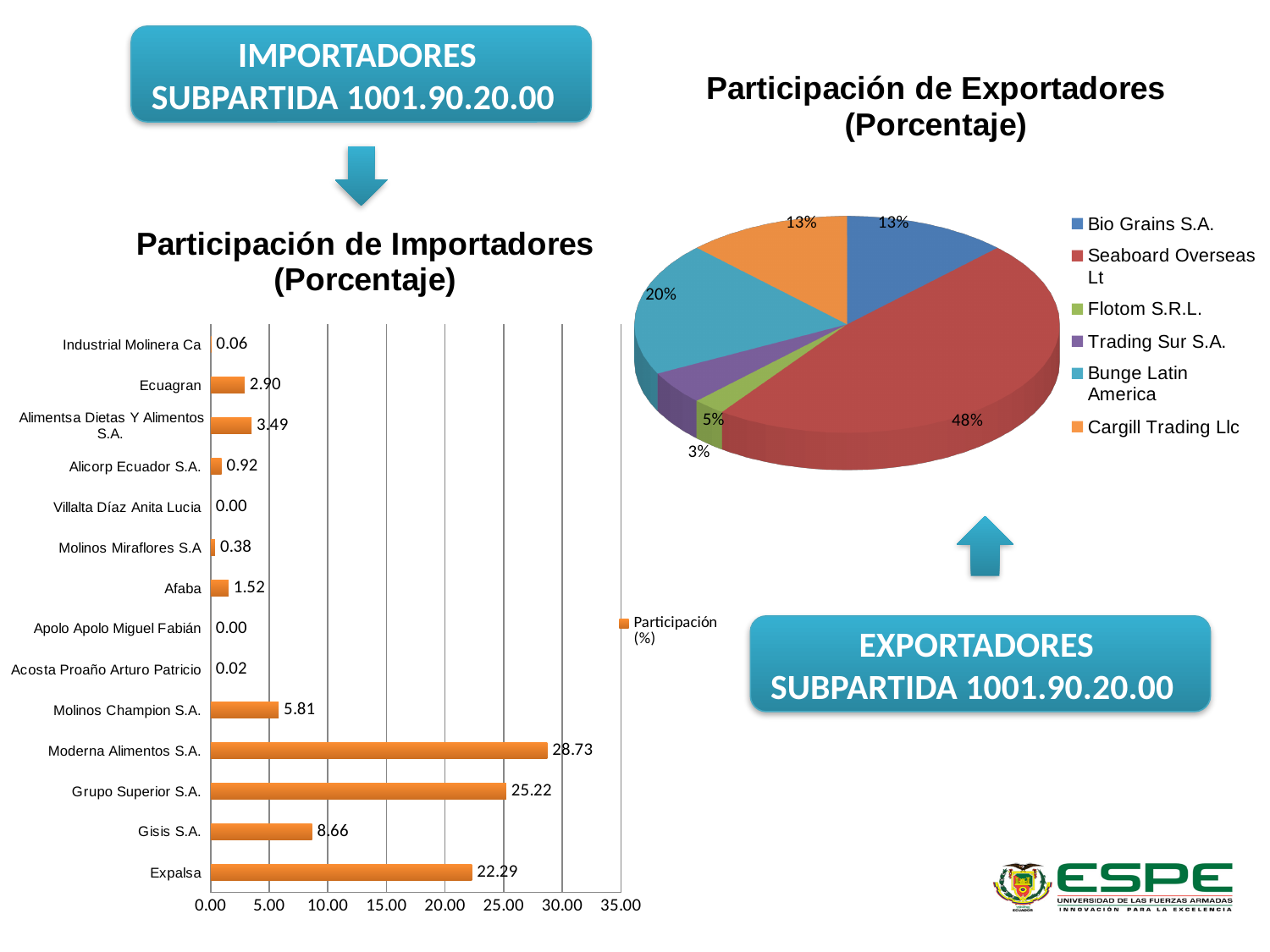
In the 'Participación de Importadores (Porcentaje)' chart, how many importers are listed? 14 What kind of chart is 'Participación de Exportadores (Porcentaje)'? Pie chart In the 'Participación de Importadores (Porcentaje)' chart, what is the difference between Moderna Alimentos S.A. and Grupo Superior S.A.? 3.51 In the 'Participación de Exportadores (Porcentaje)' pie chart, what share does Seaboard Overseas Lt have? 48% In the 'Participación de Importadores (Porcentaje)' chart, what is the value for Moderna Alimentos S.A.? 28.73 In the 'Participación de Importadores (Porcentaje)' chart, which importer has the highest participation? Moderna Alimentos S.A. In the 'Participación de Importadores (Porcentaje)' chart, which is larger, Gisis S.A. or Molinos Champion S.A.? Gisis S.A. How many exporters does the legend of the 'Participación de Exportadores (Porcentaje)' pie chart list? 6 In the 'Participación de Exportadores (Porcentaje)' pie chart, what share does Bunge Latin America have? 20% In the 'Participación de Exportadores (Porcentaje)' pie chart, which exporter has the smallest share? Flotom S.R.L. What kind of chart is 'Participación de Importadores (Porcentaje)'? Bar chart In the 'Participación de Importadores (Porcentaje)' chart, what is the value for Expalsa? 22.29